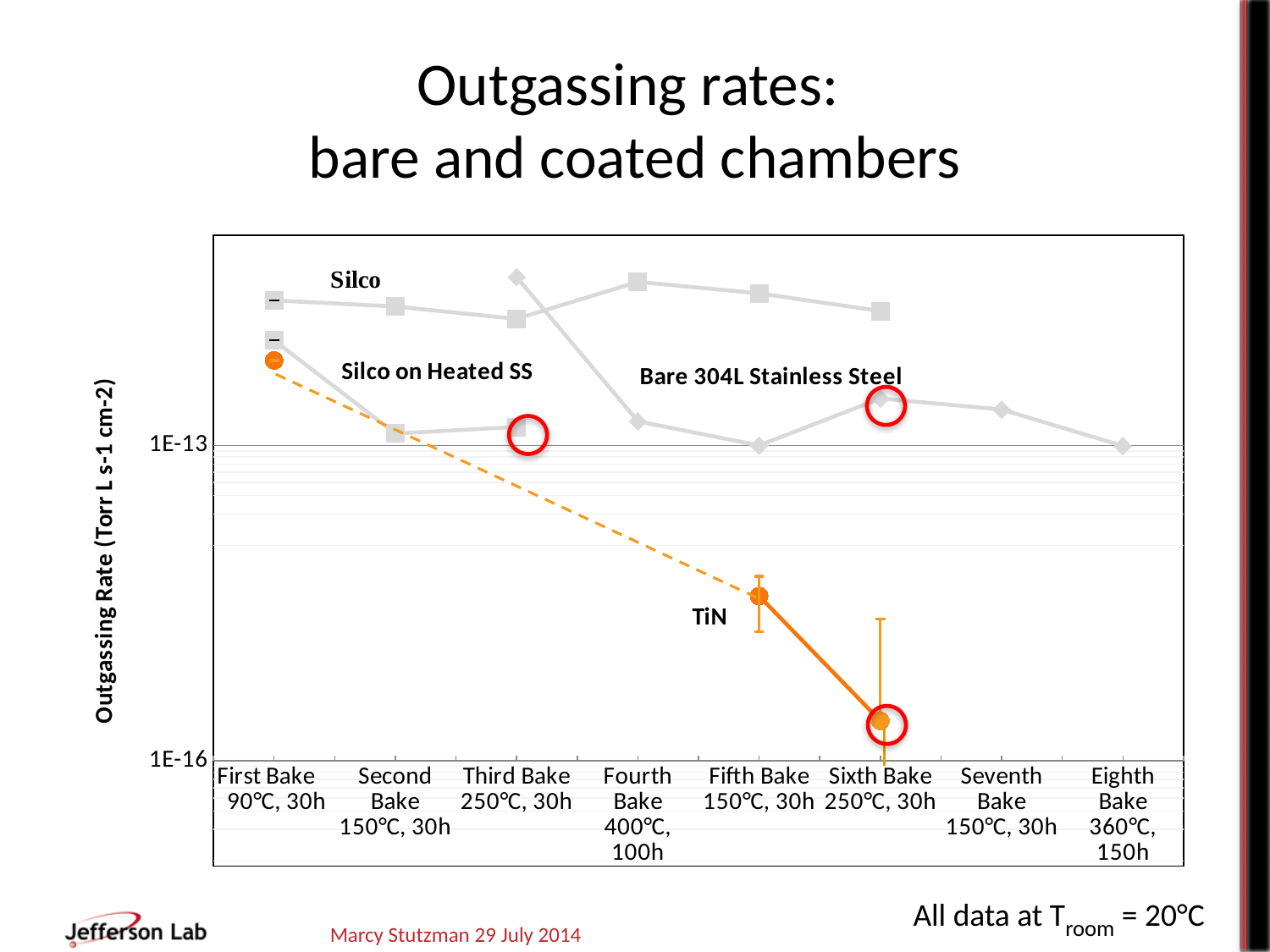
How many bake categories are shown along the x axis? 8 At which bake does the Bare 304L Stainless Steel series reach its highest value? Third Bake 250°C, 30h Is the TiN value at Fifth Bake 150°C, 30h greater or less than 1E-13? less At First Bake 90°C, 30h, which series has the higher outgassing rate, Silco or TiN? Silco What is the label of the y axis? Outgassing Rate (Torr L s-1 cm-2) Is the Bare 304L Stainless Steel value at Third Bake 250°C, 30h greater or less than 1E-13? greater Do the TiN values rise or fall from First Bake to Sixth Bake? fall Is the Silco value at First Bake 90°C, 30h greater or less than 1E-13? greater How many series are labelled on the chart? 4 What is the title of the slide's chart? Outgassing rates: bare and coated chambers What kind of chart is shown on the slide? line chart